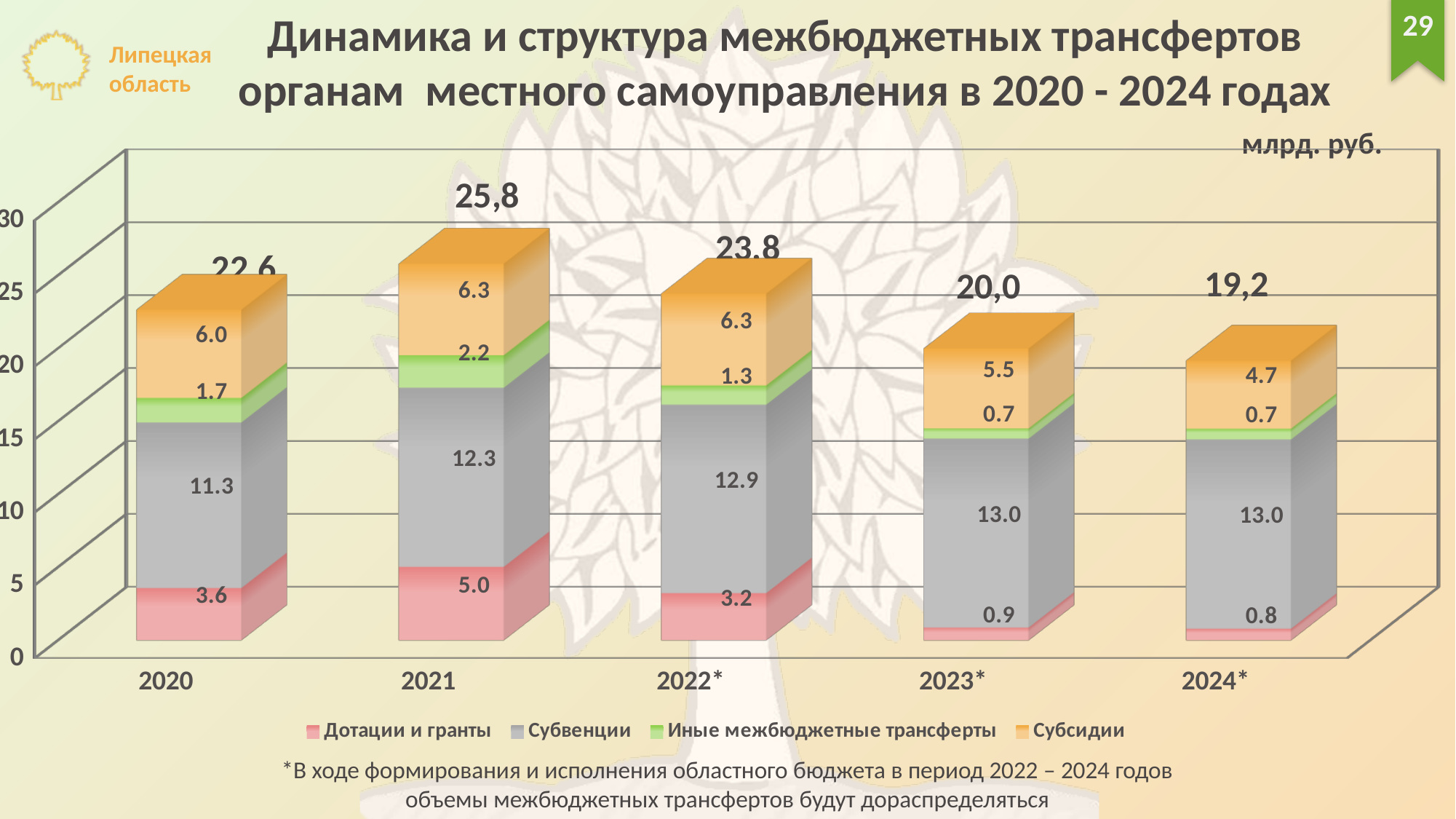
Which year has the highest total of intergovernmental transfers? 2021 Which is larger: Дотации и гранты in 2021 or in 2022*? 2021 Which year has the lowest total of intergovernmental transfers? 2024* How many years are shown on the x axis? 5 What is the total of the stacked bar for 2021? 25,8 What kind of chart is shown on the slide? Stacked bar chart What is the value of Субвенции for 2021? 12.3 What is the difference between Субсидии in 2020 and Субсидии in 2023*? 0.5 What is the value of Дотации и гранты for 2020? 3.6 What is the value of Субсидии for 2024*? 4.7 How many series does the legend list? 4 Do the bar totals rise or fall from 2021 to 2024*? Fall